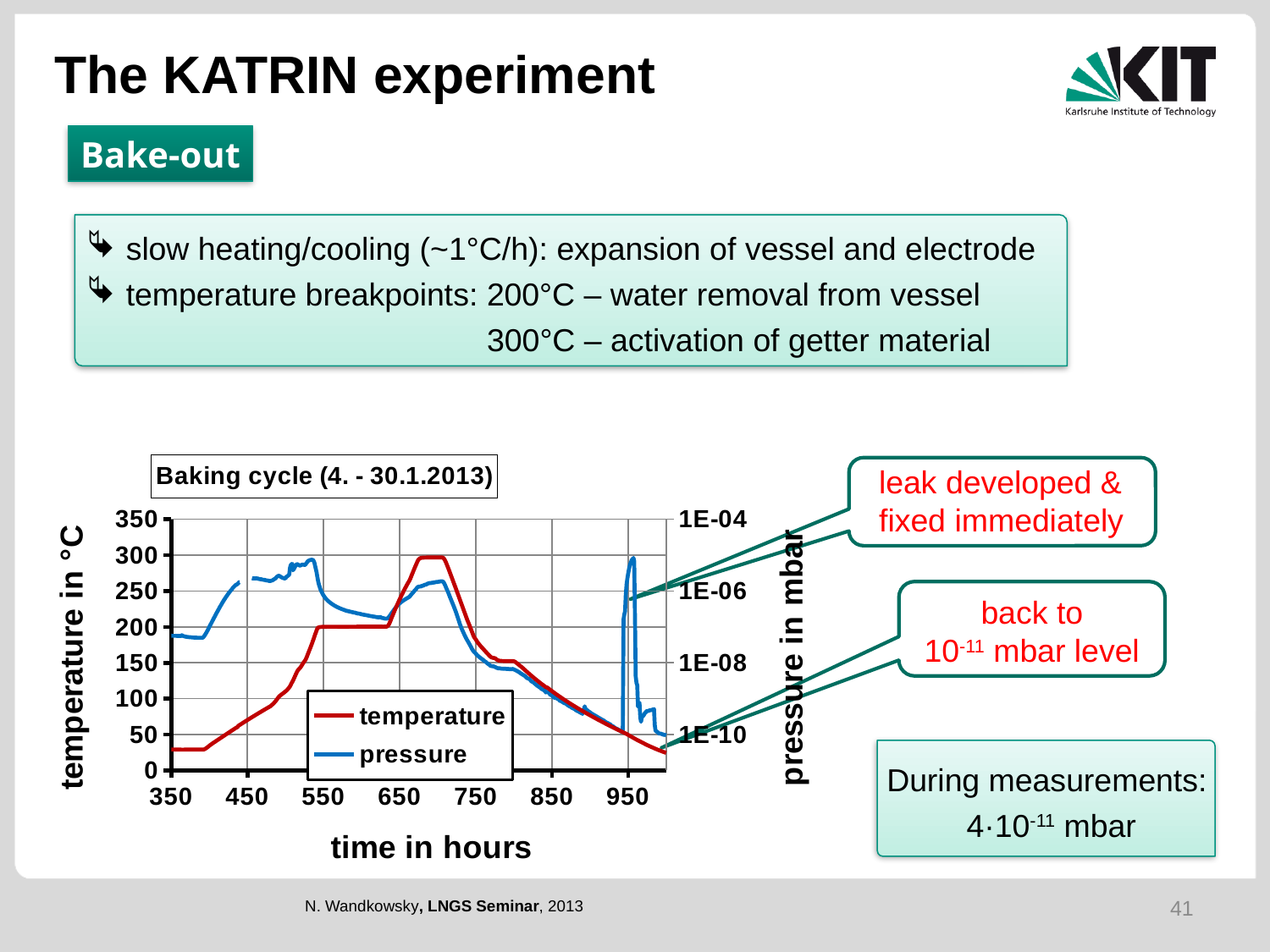
What is the label of the x axis of the chart? time in hours How many tick labels are shown on the x axis of the chart? 7 Is the temperature at 700 hours greater or less than 250? greater Is the temperature at 600 hours greater or less than 150? greater Is the temperature at 350 hours greater or less than 100? less What is the highest tick value shown on the left temperature axis? 350 What kind of chart is shown on the slide? line chart Which series is drawn in red in the chart? temperature Does the temperature rise or fall between 750 and 950 hours? fall What is the label of the right-hand y axis of the chart? pressure in mbar How many series does the chart legend list? 2 What is the title of the chart? Baking cycle (4. - 30.1.2013)